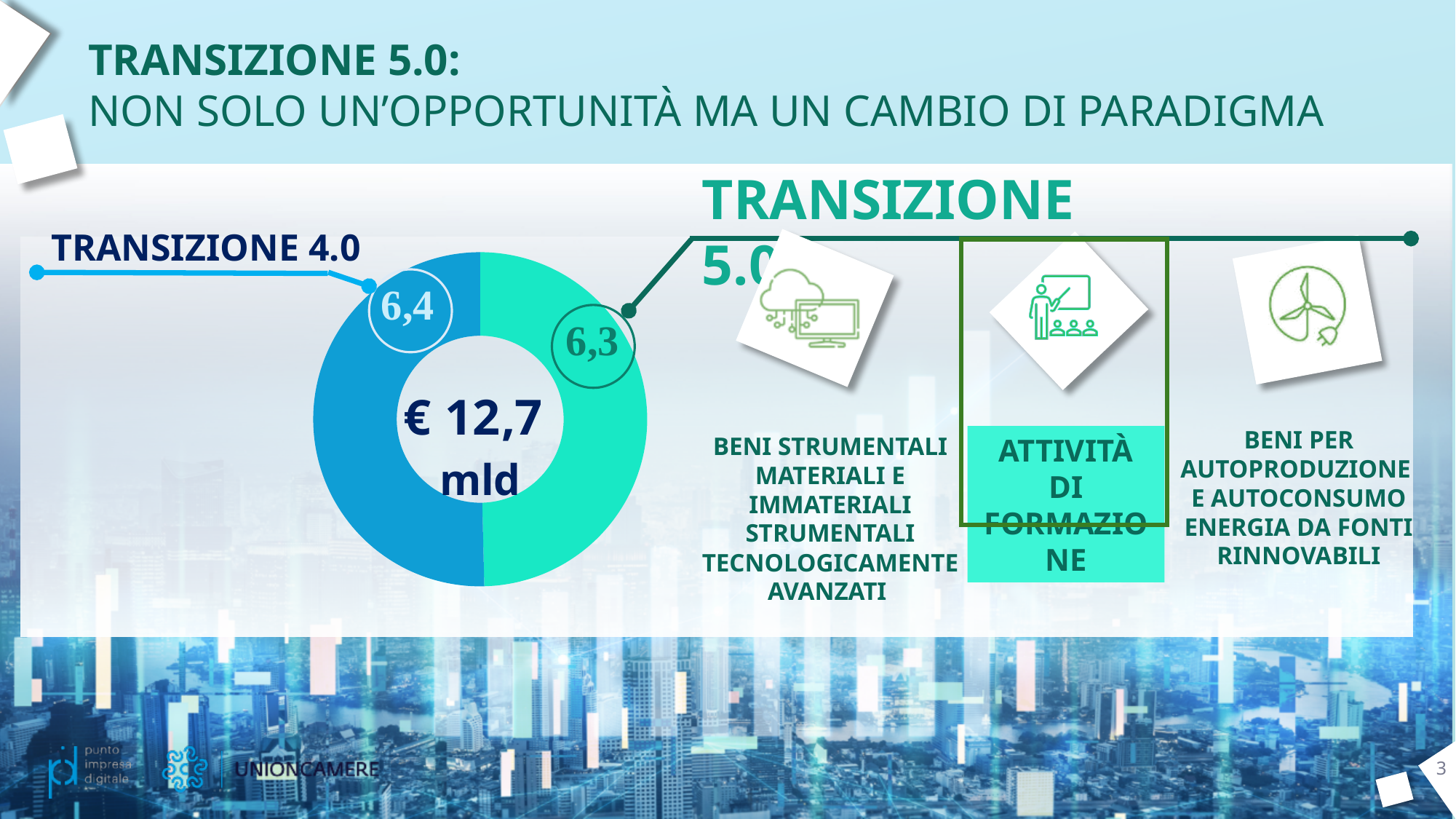
Which segment of the pie chart has the largest value? Transizione 4.0 How many segments does the pie chart have? 2 Which segment of the pie chart has the larger value, Transizione 4.0 or Transizione 5.0? Transizione 4.0 What colour is the Transizione 5.0 segment of the pie chart? turquoise Which segment of the pie chart has the smallest value? Transizione 5.0 What is the difference between the values for Transizione 4.0 and Transizione 5.0 in the pie chart? 0,1 What colour is the Transizione 4.0 segment of the pie chart? blue What value is shown for Transizione 5.0 in the pie chart? 6,3 What total is printed in the centre of the pie chart? € 12,7 mld What kind of chart is shown on the slide? doughnut chart What value is shown for Transizione 4.0 in the pie chart? 6,4